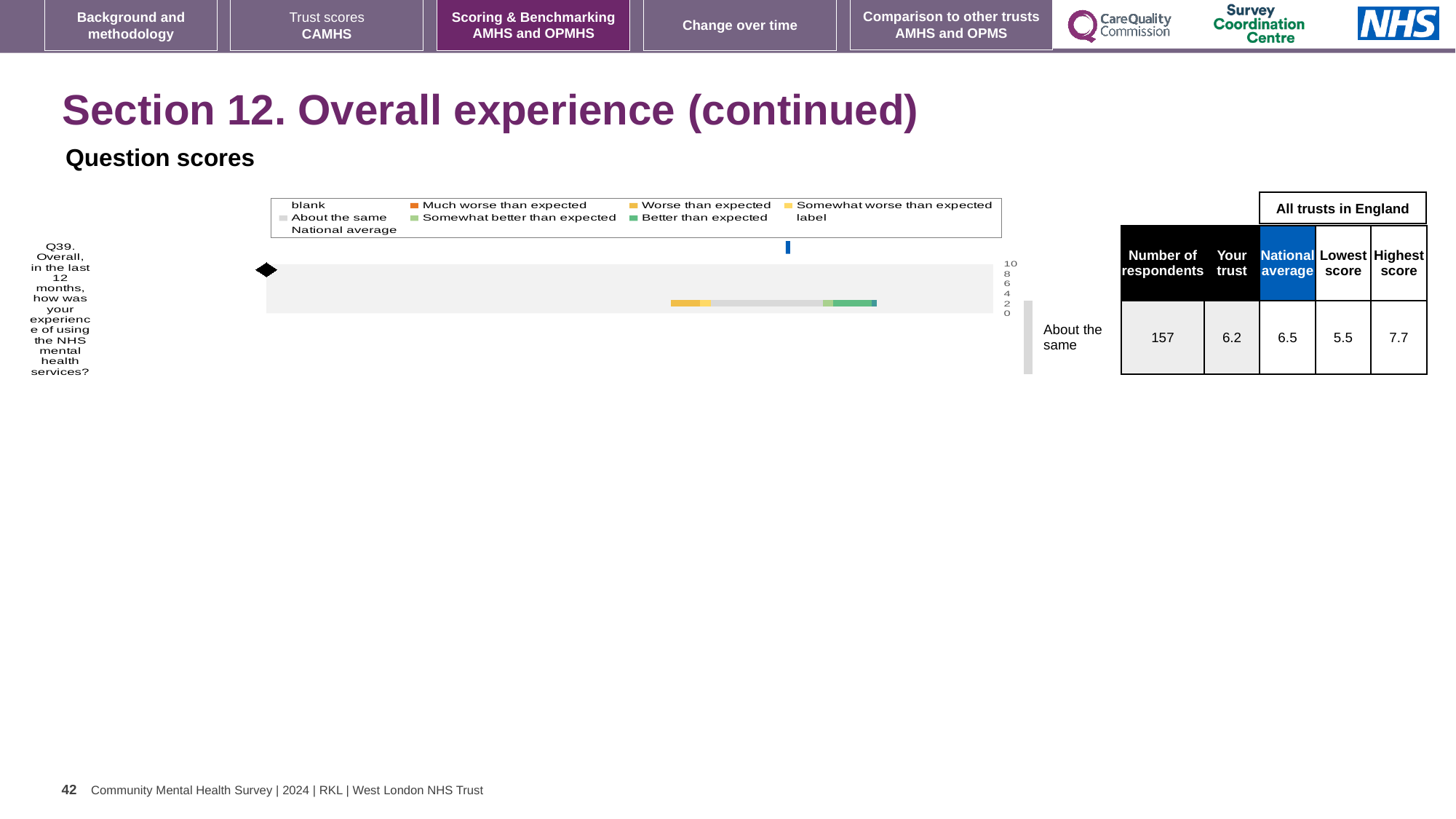
According to the table, what is the national average score for Q39? 6.5 According to the table, what is the 'Your trust' score for Q39? 6.2 According to the table, what is the lowest score among all trusts in England for Q39? 5.5 Which legend entry is shown in dark green? Better than expected According to the table, what is the highest score among all trusts in England for Q39? 7.7 Which is larger for Q39, the 'Your trust' score or the national average? National average What is the difference between the highest score and the lowest score for Q39? 2.2 How many questions (categories) are plotted in the chart? 1 What kind of chart is shown on the slide for Q39? bar chart What benchmark category is the trust's Q39 score placed in? About the same What is the highest value shown on the chart's numeric axis? 10 According to the table, how many respondents answered Q39? 157